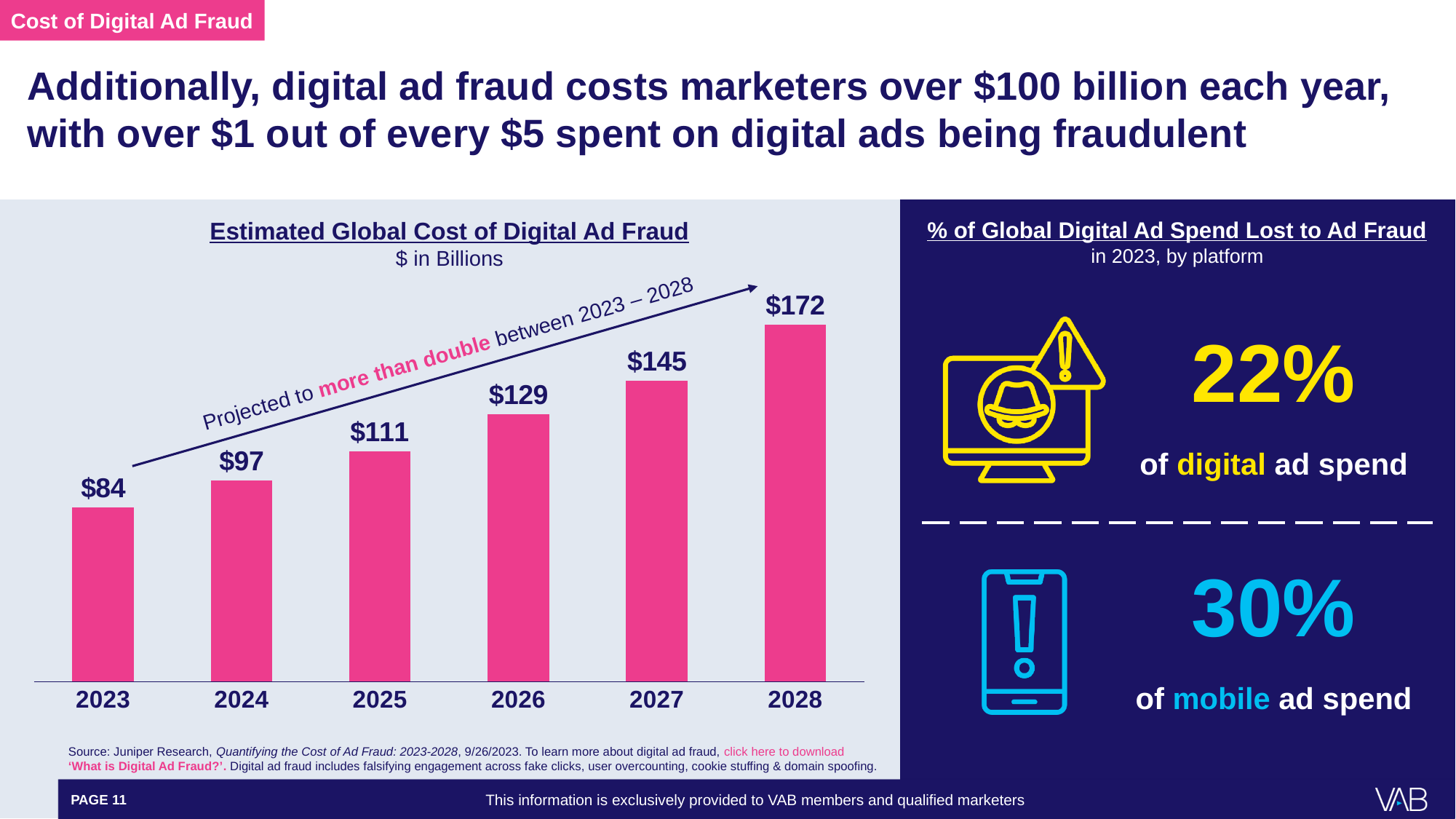
Which is larger, the estimated cost of digital ad fraud in 2024 or in 2026? 2026 Which year has the highest estimated global cost of digital ad fraud? 2028 What is the estimated global cost of digital ad fraud for 2023? $84 What kind of chart is the Estimated Global Cost of Digital Ad Fraud chart? Bar chart What is the estimated global cost of digital ad fraud for 2025? $111 How many years are shown in the Estimated Global Cost of Digital Ad Fraud chart? 6 In what unit are the values in the Estimated Global Cost of Digital Ad Fraud chart expressed? $ in Billions What is the difference between the estimated cost of digital ad fraud in 2028 and in 2023? $88 What is the estimated global cost of digital ad fraud for 2028? $172 Do the estimated global costs of digital ad fraud rise or fall from 2023 to 2028? Rise Which year has the lowest estimated global cost of digital ad fraud? 2023 What is the difference between the estimated cost of digital ad fraud in 2027 and in 2026? $16